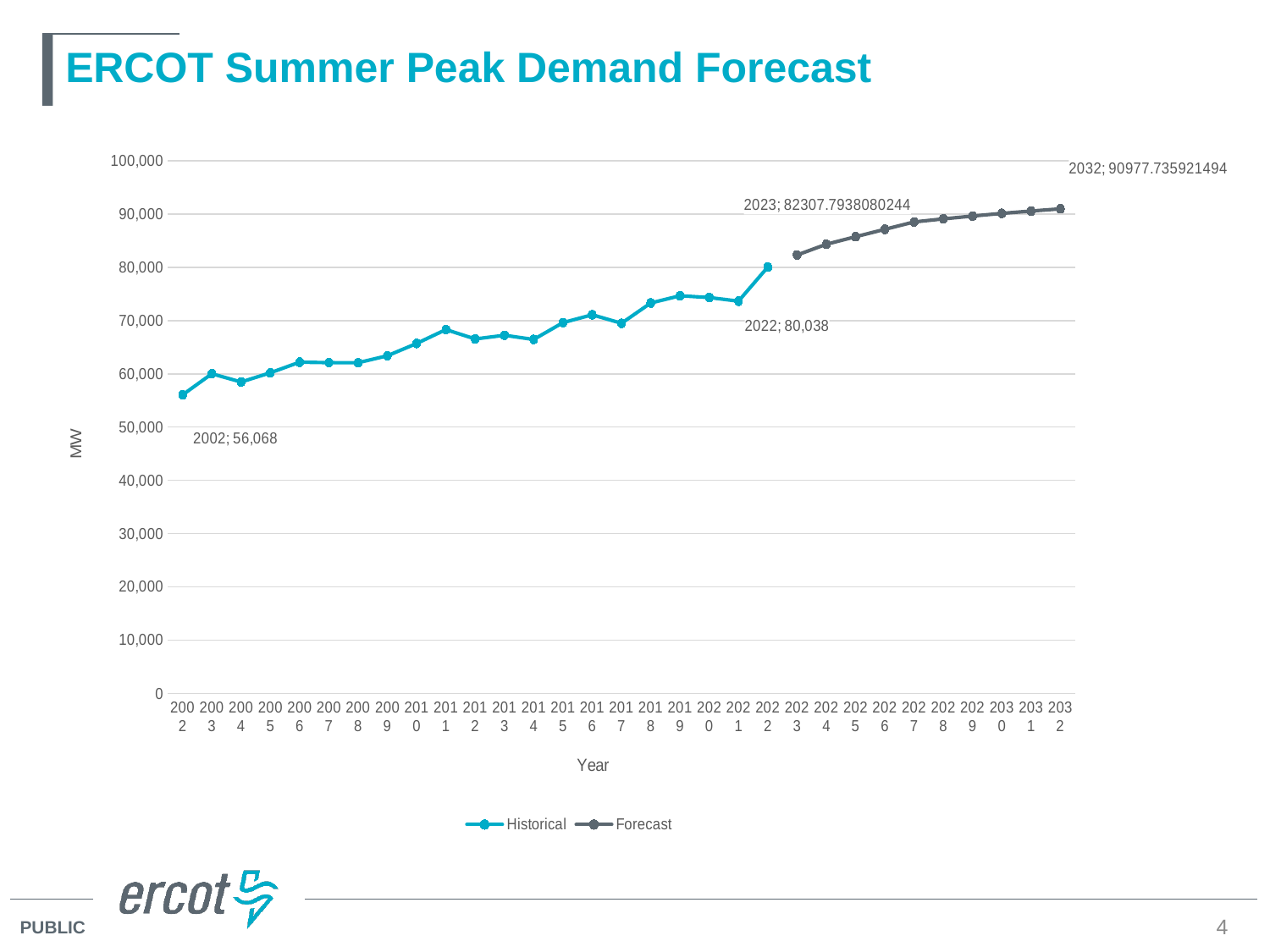
What is the forecast value labeled for 2023? 82307.7938080244 What is the historical summer peak demand value labeled for 2022? 80,038 How many series does the legend list? 2 Which year has the highest value on the chart? 2032 How much higher is the labeled 2022 value than the labeled 2002 value? 23,970 Which year has the lowest value on the chart? 2002 What is the historical summer peak demand value labeled for 2002? 56,068 What is the overall trend of summer peak demand from 2002 to 2032? Rising Is the value for 2027 greater or less than 90,000? less What is the forecast value labeled for 2032? 90977.735921494 Is the value for 2012 greater or less than 70,000? less What type of chart is shown on the slide? Line chart